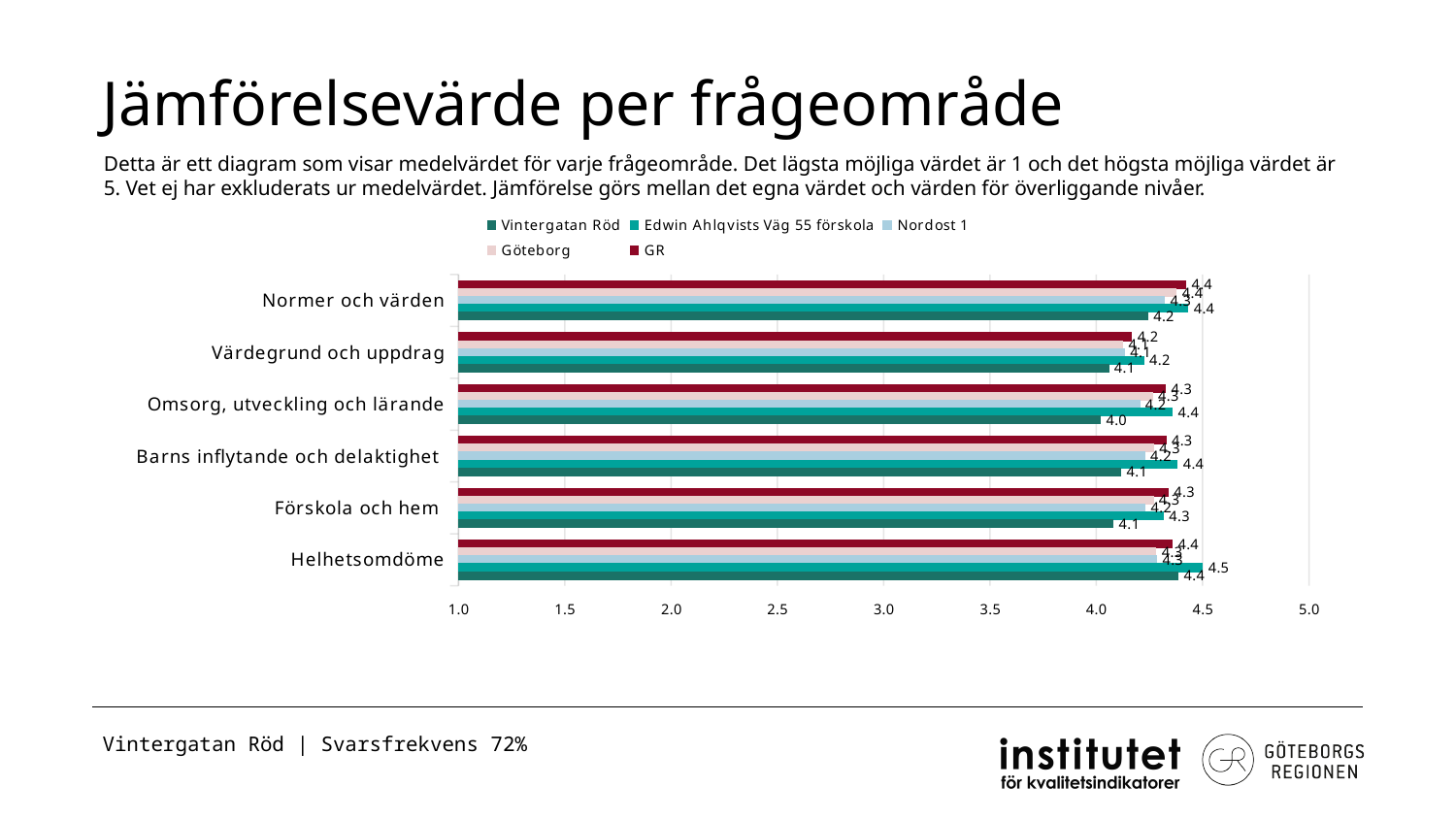
What is the difference between Edwin Ahlqvists Väg 55 förskola and Vintergatan Röd in Omsorg, utveckling och lärande? 0.4 What is the title of the chart slide? Jämförelsevärde per frågeområde Which is larger in Normer och värden: the value for Vintergatan Röd or the value for Edwin Ahlqvists Väg 55 förskola? Edwin Ahlqvists Väg 55 förskola How many question areas (categories) are shown on the chart? 6 What is the value for Vintergatan Röd in Omsorg, utveckling och lärande? 4.0 In which question area does Vintergatan Röd have its lowest value? Omsorg, utveckling och lärande In which question area does Vintergatan Röd have its highest value? Helhetsomdöme How many series does the legend list? 5 What is the value for GR in Värdegrund och uppdrag? 4.2 What kind of chart is shown on the slide? bar chart What is the value for Edwin Ahlqvists Väg 55 förskola in Helhetsomdöme? 4.5 What is the value for Vintergatan Röd in Helhetsomdöme? 4.4